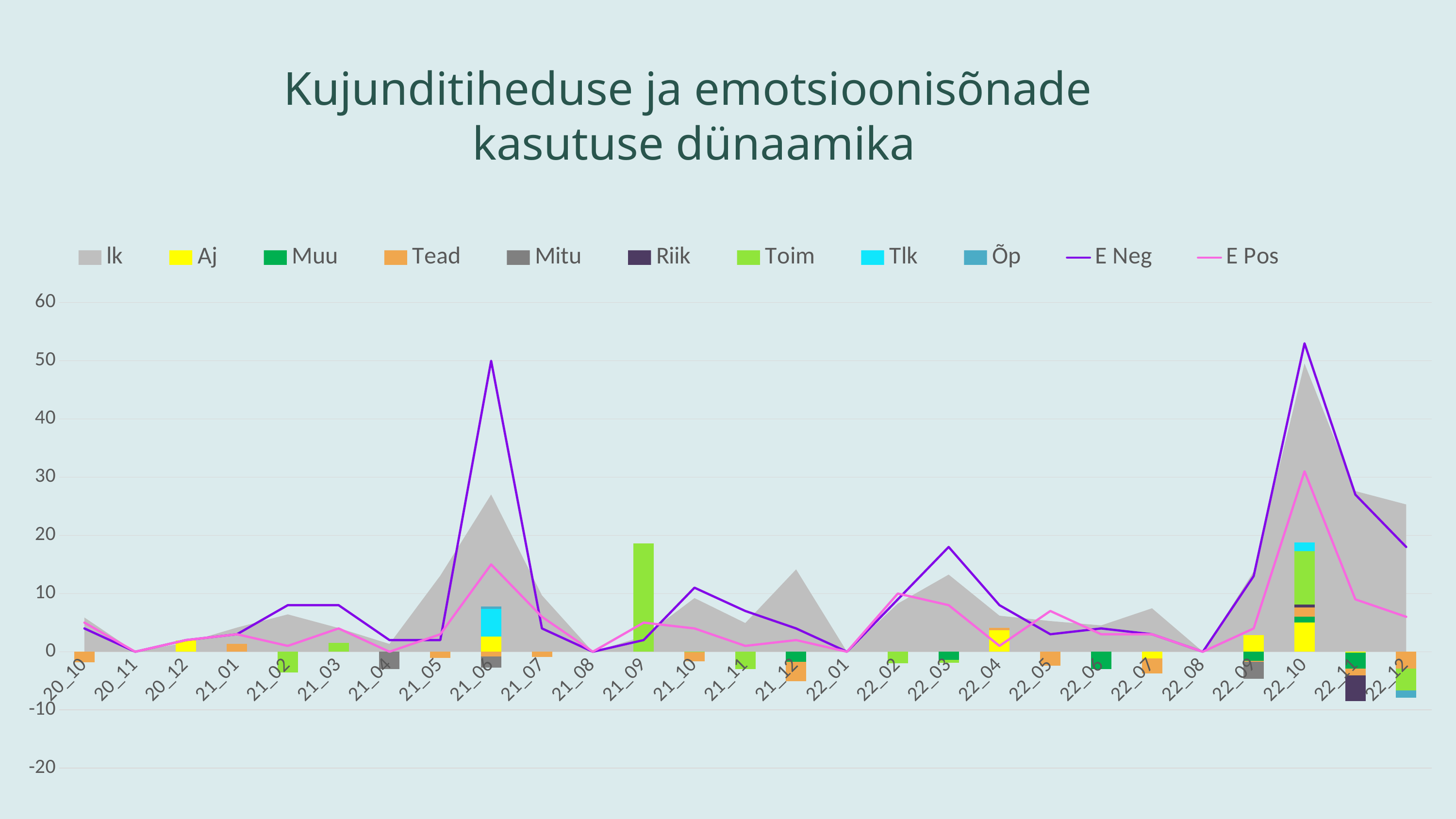
Is the value of E Neg at 21_06 greater or less than 40? greater What is the title of the chart? Kujunditiheduse ja emotsioonisõnade kasutuse dünaamika Is the value of E Neg at 22_10 greater or less than 50? greater How many months are shown on the x axis? 27 How many series does the legend list? 11 At which month does the E Pos line reach its highest value? 22_10 Which two series are drawn as lines rather than bars or area? E Neg and E Pos Does the E Neg line rise or fall from 22_10 to 22_12? fall At 21_06, which is larger: E Neg or E Pos? E Neg Is the Toim bar at 21_09 greater or less than 10? greater At 22_05, which is larger: E Neg or E Pos? E Pos